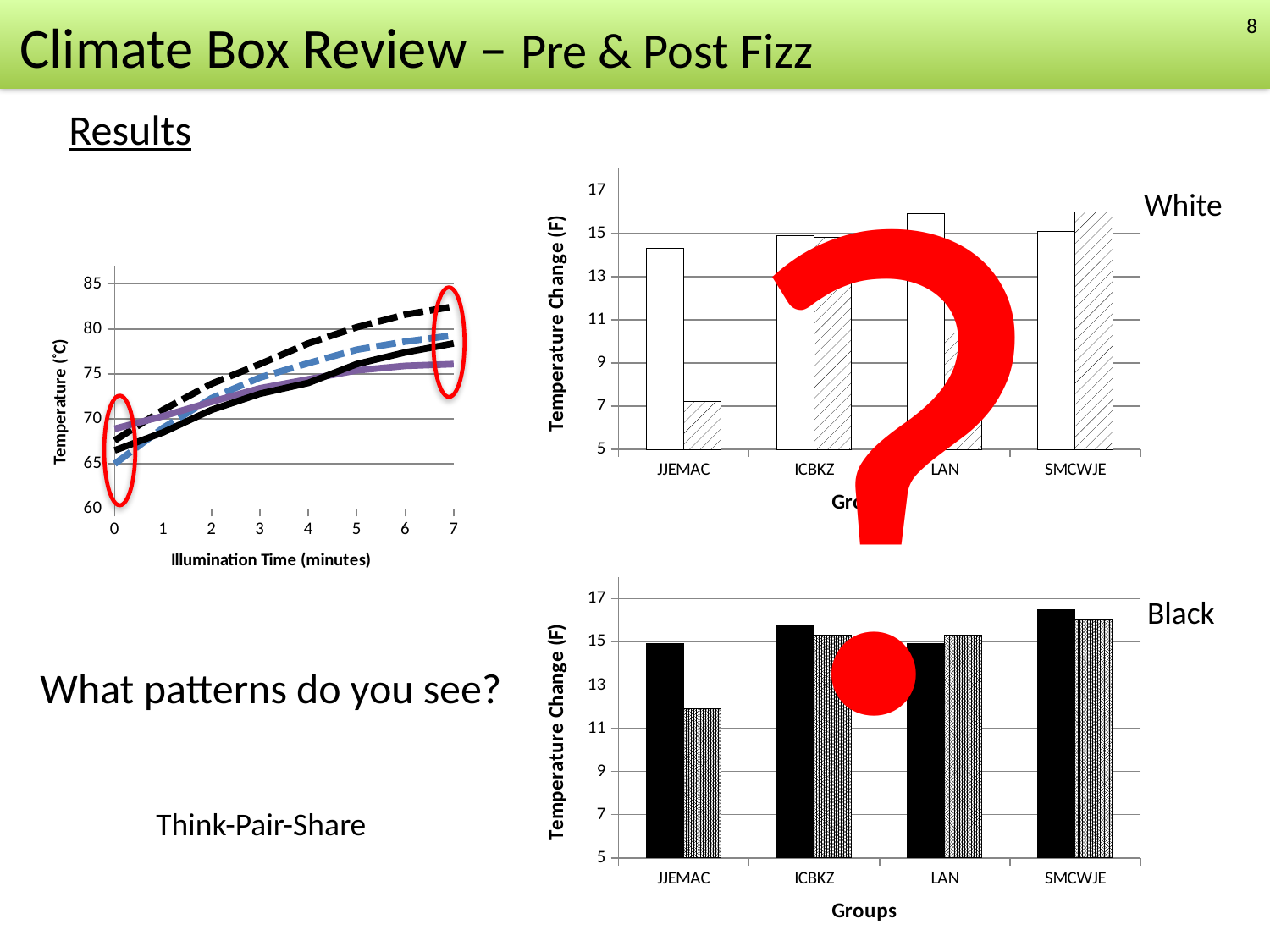
What kind of chart is the 'White' chart on the upper right? bar chart In the 'White' bar chart, which bar is the lowest? the hatched bar for JJEMAC In the 'Black' bar chart, for JJEMAC, which is larger: the solid black bar or the dotted bar? the solid black bar How many groups are shown on the x axis of the 'White' bar chart? 4 In the line chart on the left, what is the label of the x axis? Illumination Time (minutes) In the line chart on the left, is the value of the black dashed line at 7 minutes greater or less than 80? greater In the line chart on the left, do the temperatures rise or fall as illumination time increases? rise In the 'White' bar chart, is the hatched bar for JJEMAC greater or less than 9? less In the 'Black' bar chart, is the dotted bar for JJEMAC greater or less than 13? less In the 'Black' bar chart, which group has the highest bar? SMCWJE In the 'Black' bar chart, which bar is the lowest? the dotted bar for JJEMAC What kind of chart is the chart on the left of the slide, showing Temperature against Illumination Time? line chart